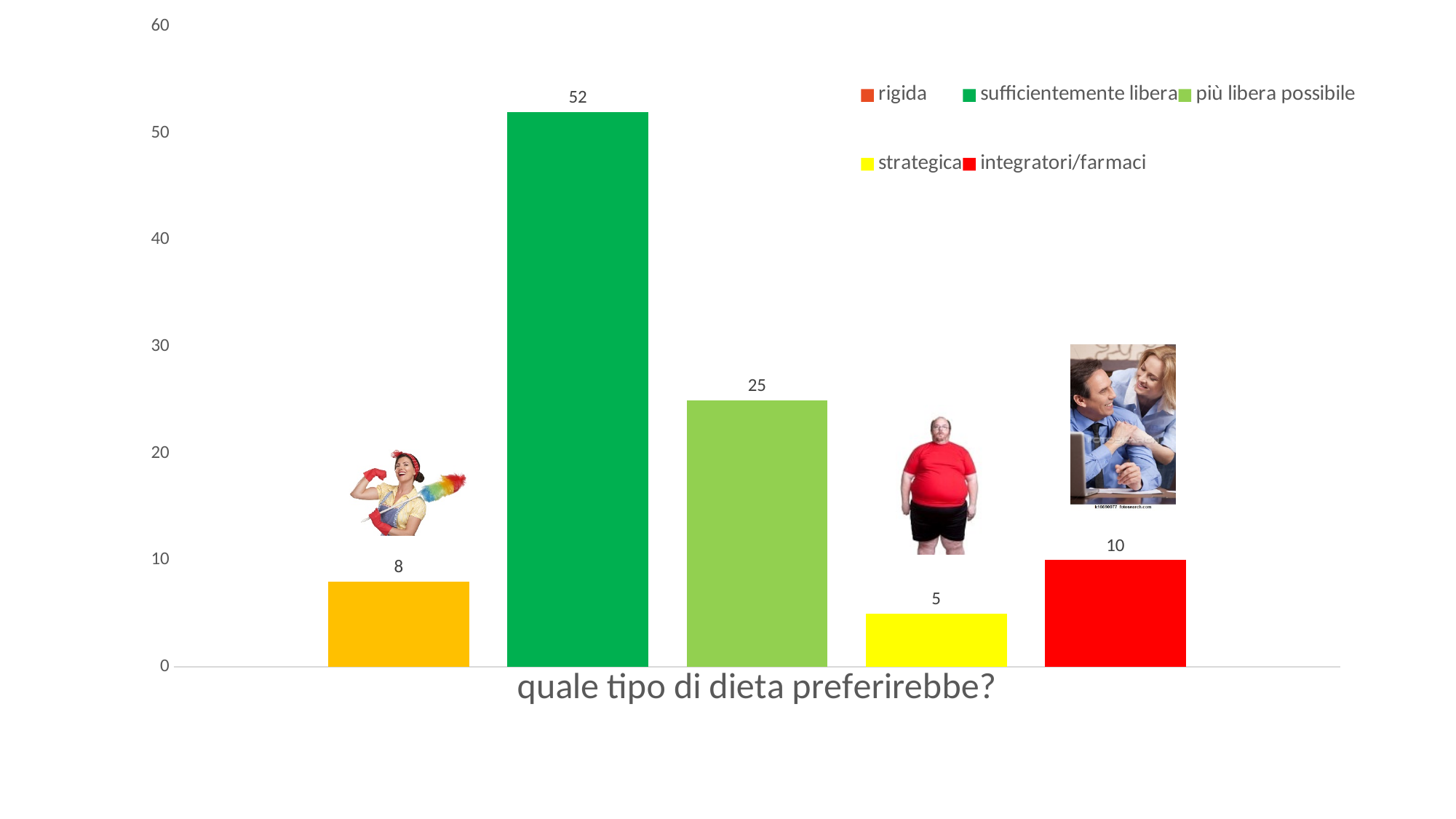
How many categories are plotted in the chart? 5 What value is shown for 'strategica'? 5 What kind of chart is shown on the slide? bar chart How many entries does the legend list? 5 What is the title shown below the chart? quale tipo di dieta preferirebbe? Which is larger, the value for 'rigida' or the value for 'integratori/farmaci'? integratori/farmaci What value is shown for 'integratori/farmaci'? 10 What is the difference between the values for 'sufficientemente libera' and 'più libera possibile'? 27 What value is shown for 'più libera possibile'? 25 Which category has the highest value? sufficientemente libera What value is shown for 'sufficientemente libera'? 52 Which category has the lowest value? strategica